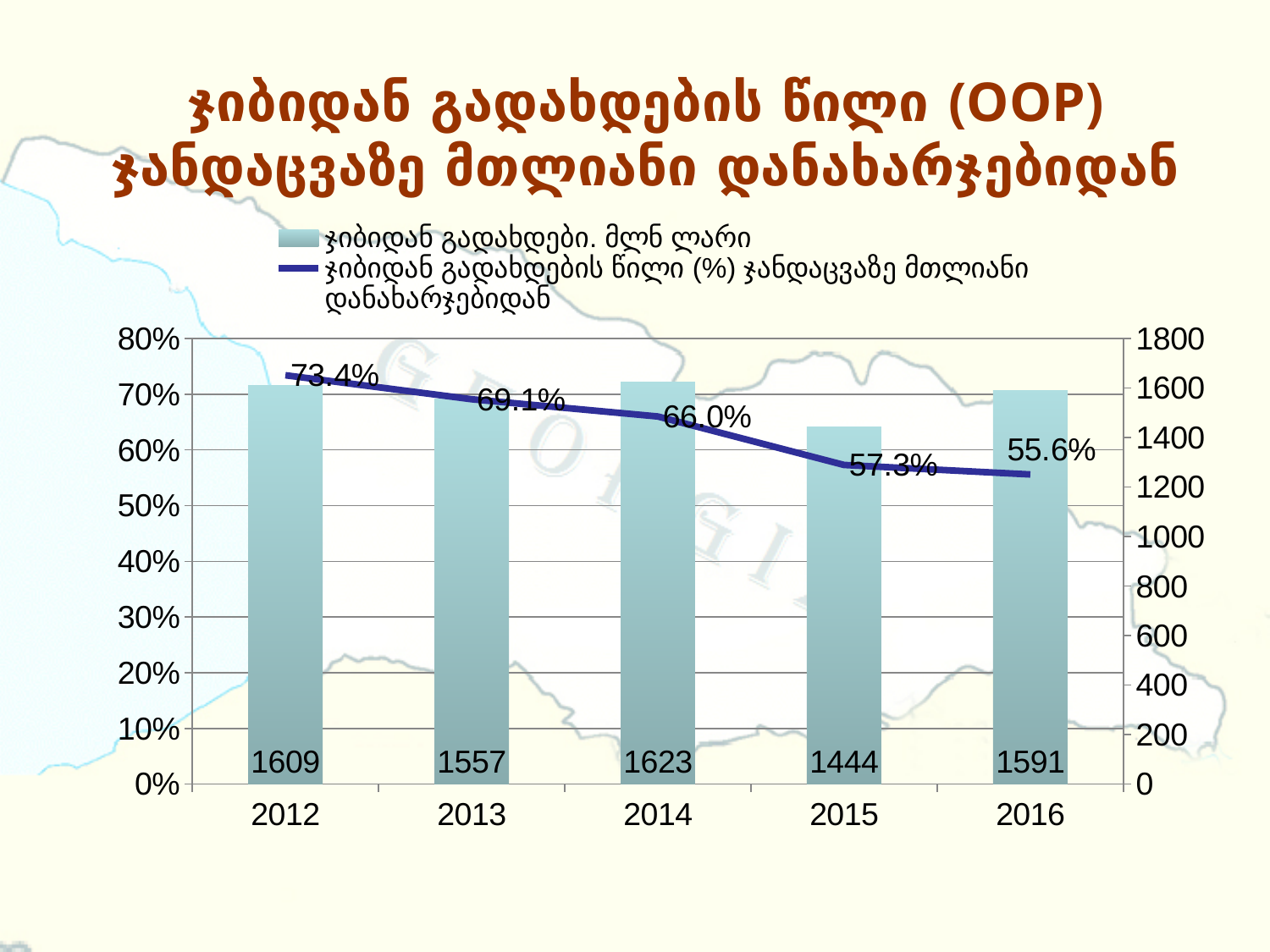
Does the line series rise or fall from 2012 to 2016? fall What is the value of the bar for 2014? 1623 What percentage does the line show for 2012? 73.4% What kind of chart is shown on the slide? Combined bar and line chart Which year has the highest bar value? 2014 How many years are shown on the x axis? 5 What is the difference between the bar values for 2014 and 2015? 179 Which year has the lowest bar value? 2015 What is the difference between the line percentages for 2012 and 2016? 17.8% How many series does the legend list? 2 What percentage does the line show for 2016? 55.6% Which is larger, the bar value for 2012 or for 2016? 2012